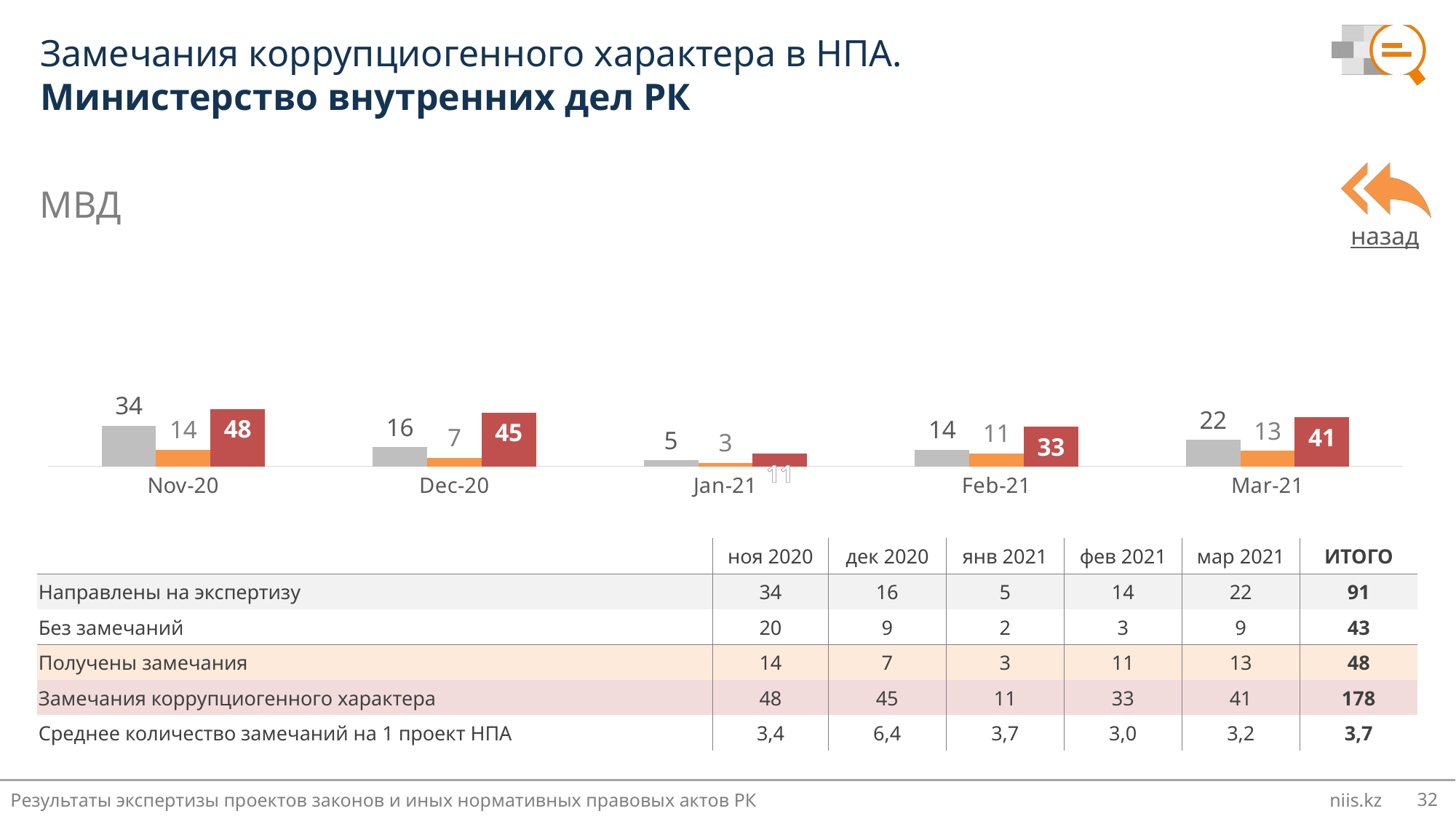
What is the value of the grey bar for Mar-21? 22 How many months (categories) are shown on the x axis of the chart? 5 In which month is the grey bar the lowest? Jan-21 What is the value of the red bar for Nov-20? 48 What is the value of the orange bar for Feb-21? 11 In which month is the red bar the highest? Nov-20 What is the difference between the red bar values for Nov-20 and Dec-20? 3 Which is larger: the grey bar for Dec-20 or the grey bar for Feb-21? Dec-20 What is the value of the red bar for Jan-21? 11 Do the red bar values rise or fall from Nov-20 to Jan-21? fall What is the difference between the grey bar and the orange bar for Nov-20? 20 What type of chart is shown on the slide? bar chart